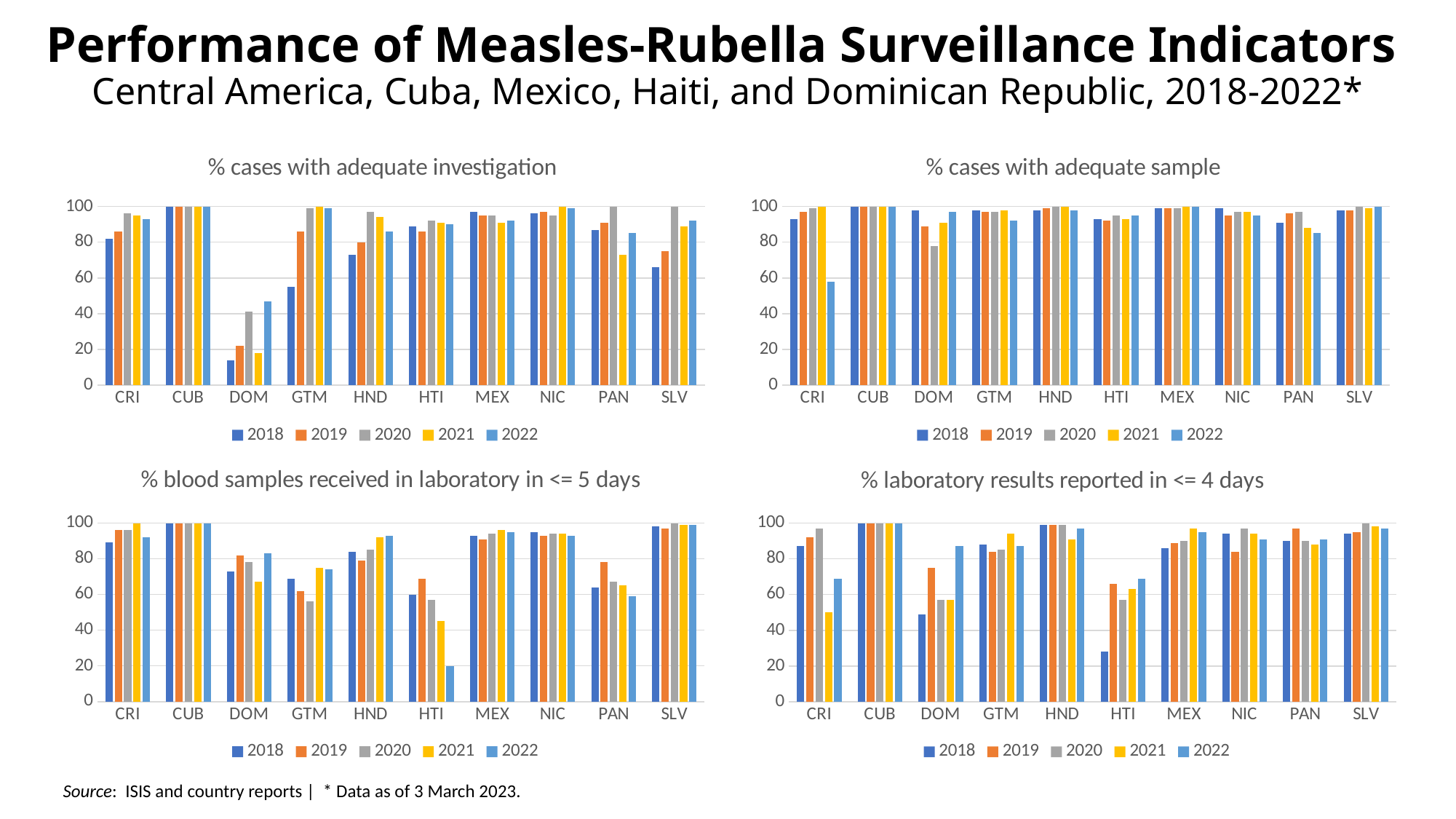
Which years are listed in the legend of the '% blood samples received in laboratory in <= 5 days' chart? 2018, 2019, 2020, 2021, 2022 On the '% cases with adequate investigation' chart, is the 2018 value for DOM greater or less than 20? less On the '% blood samples received in laboratory in <= 5 days' chart, which is larger for 2022: PAN or SLV? SLV On the '% laboratory results reported in <= 4 days' chart, is the 2018 value for HTI greater or less than 40? less What kind of chart is the '% cases with adequate investigation' chart? bar chart On the '% blood samples received in laboratory in <= 5 days' chart, is the 2021 value for HTI greater or less than 60? less On the '% cases with adequate investigation' chart, which country has the lowest 2018 value? DOM On the '% cases with adequate investigation' chart, which is larger for 2022: DOM or GTM? GTM How many countries are shown on the x axis of the '% laboratory results reported in <= 4 days' chart? 10 On the '% laboratory results reported in <= 4 days' chart, which country has the lowest 2018 value? HTI How many series does the legend list on the '% cases with adequate sample' chart? 5